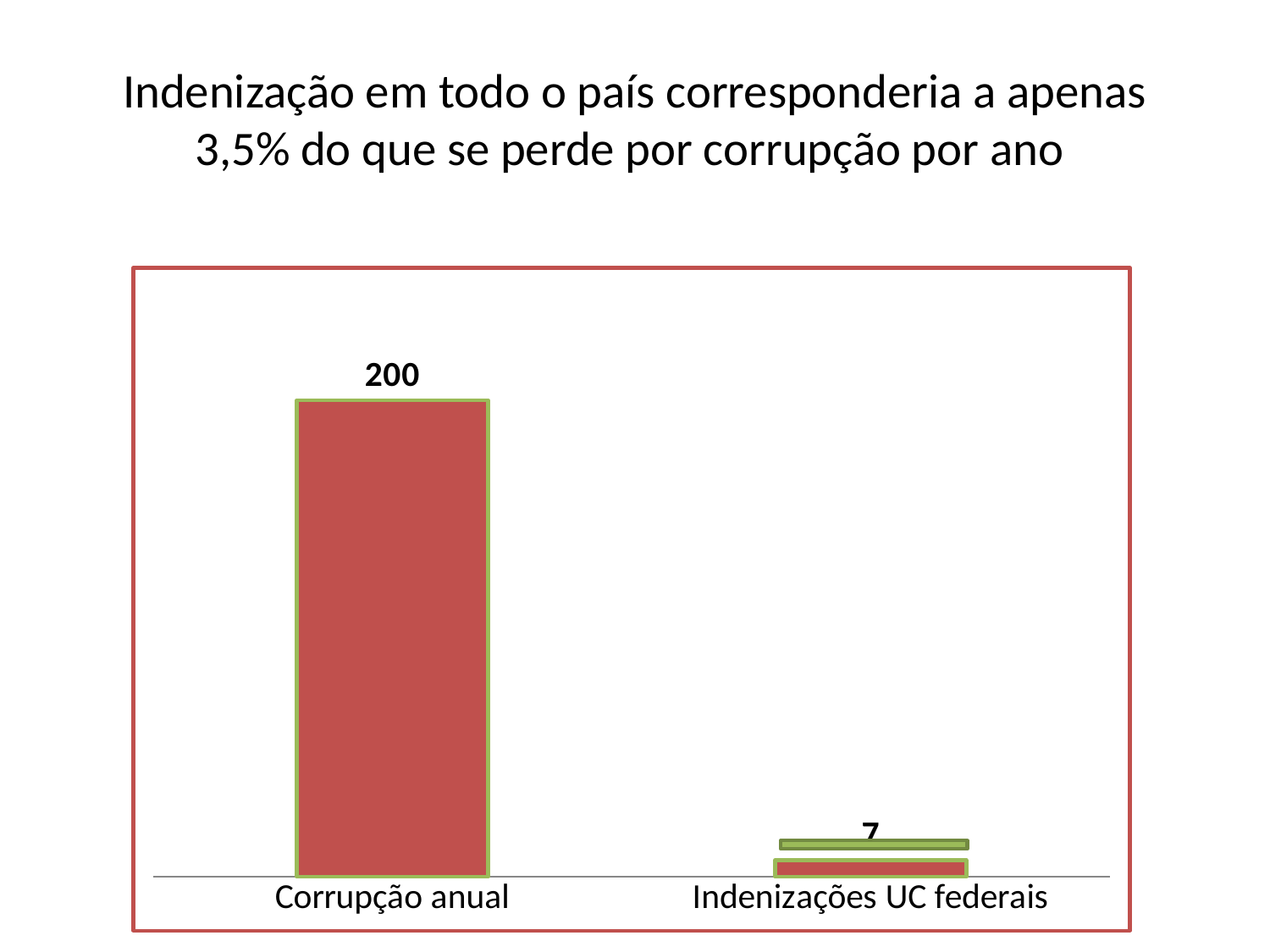
What is the value for Corrupção anual? 200 Which category has the highest value? Corrupção anual Do the values rise or fall from left to right along the x axis? Fall Which is larger, the value for Corrupção anual or the value for Indenizações UC federais? Corrupção anual What colour are the bars in the chart? Red What is the title of the slide? Indenização em todo o país corresponderia a apenas 3,5% do que se perde por corrupção por ano What is the difference between the values for Corrupção anual and Indenizações UC federais? 193 What kind of chart is shown on the slide? Bar chart How many categories are shown in the chart? 2 What is the value for Indenizações UC federais? 7 Which category has the lowest value? Indenizações UC federais